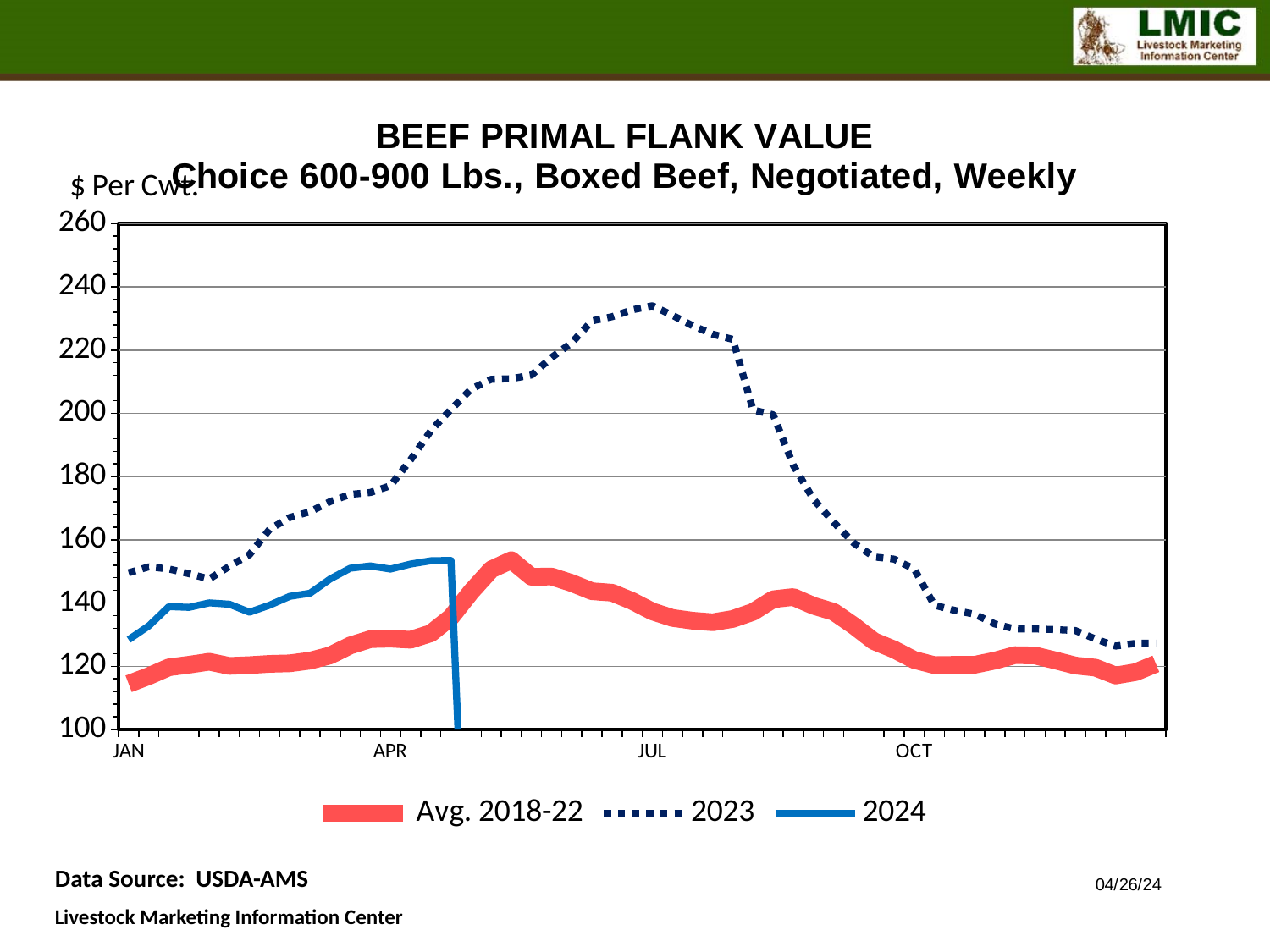
What is the title of the chart? BEEF PRIMAL FLANK VALUE Is the value of the Avg. 2018-22 series at JAN greater or less than 120? less Is the value of the 2024 series at APR greater or less than 140? greater Which series reaches the highest value on the chart? 2023 Is the value of the 2023 series at JAN greater or less than 140? greater What kind of chart is shown on the slide? line chart How many series does the legend list? 3 Does the 2023 series rise or fall from JAN to JUL? rise What unit is shown on the y-axis label? $ Per Cwt. Which series has the higher value at JUL, 2023 or Avg. 2018-22? 2023